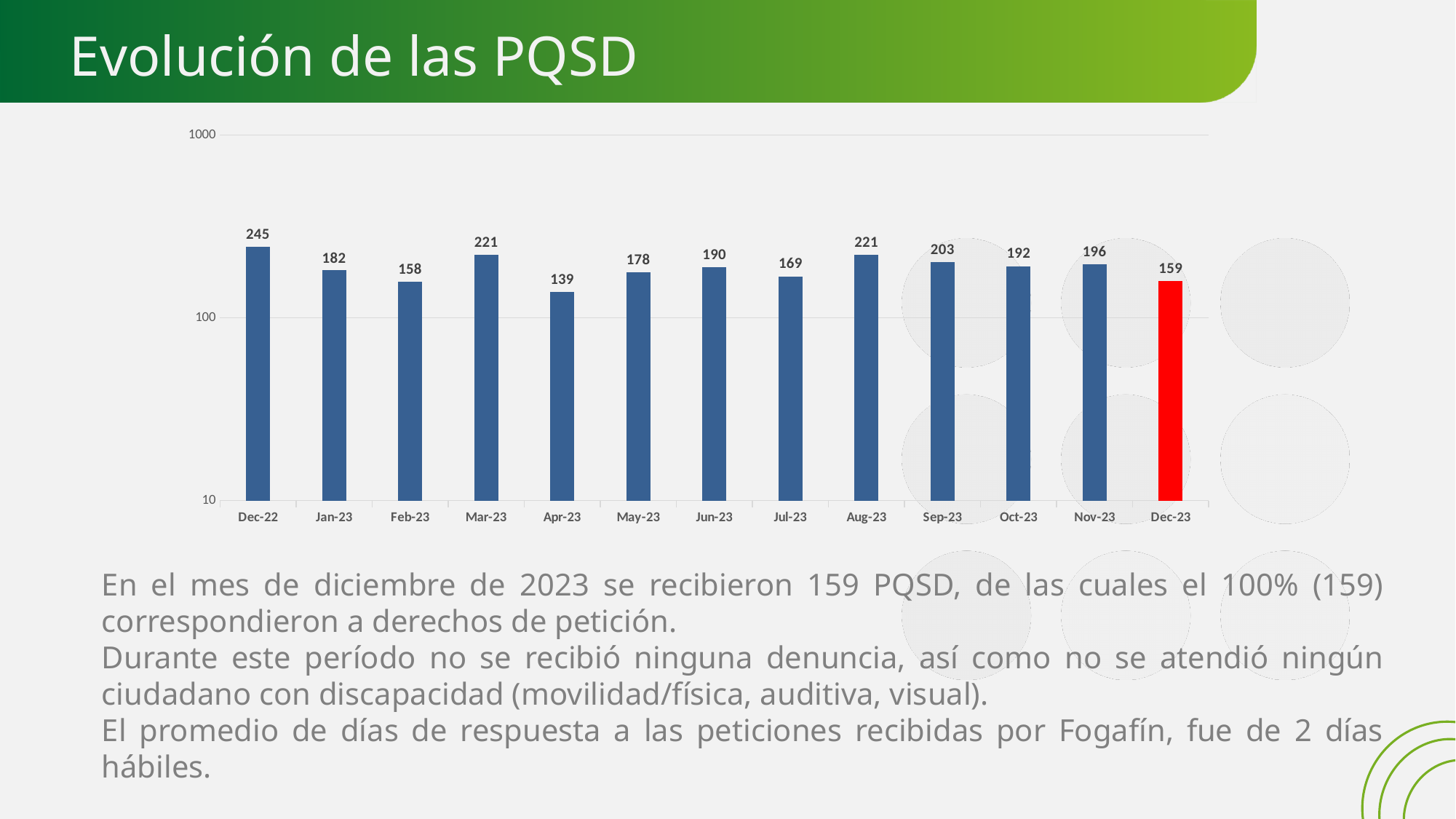
Is the value for Apr-23 greater or less than 100? greater Which bar is coloured red? Dec-23 What is the value for Sep-23? 203 What is the value for Apr-23? 139 Which month has the lowest value? Apr-23 How many months are shown on the x axis? 13 What is the value for Dec-23? 159 What is the difference between the values for Dec-22 and Dec-23? 86 What kind of chart is shown on the slide? bar chart Which is larger, the value for Sep-23 or the value for Jul-23? Sep-23 What is the difference between the values for Mar-23 and Feb-23? 63 Which month has the highest value? Dec-22